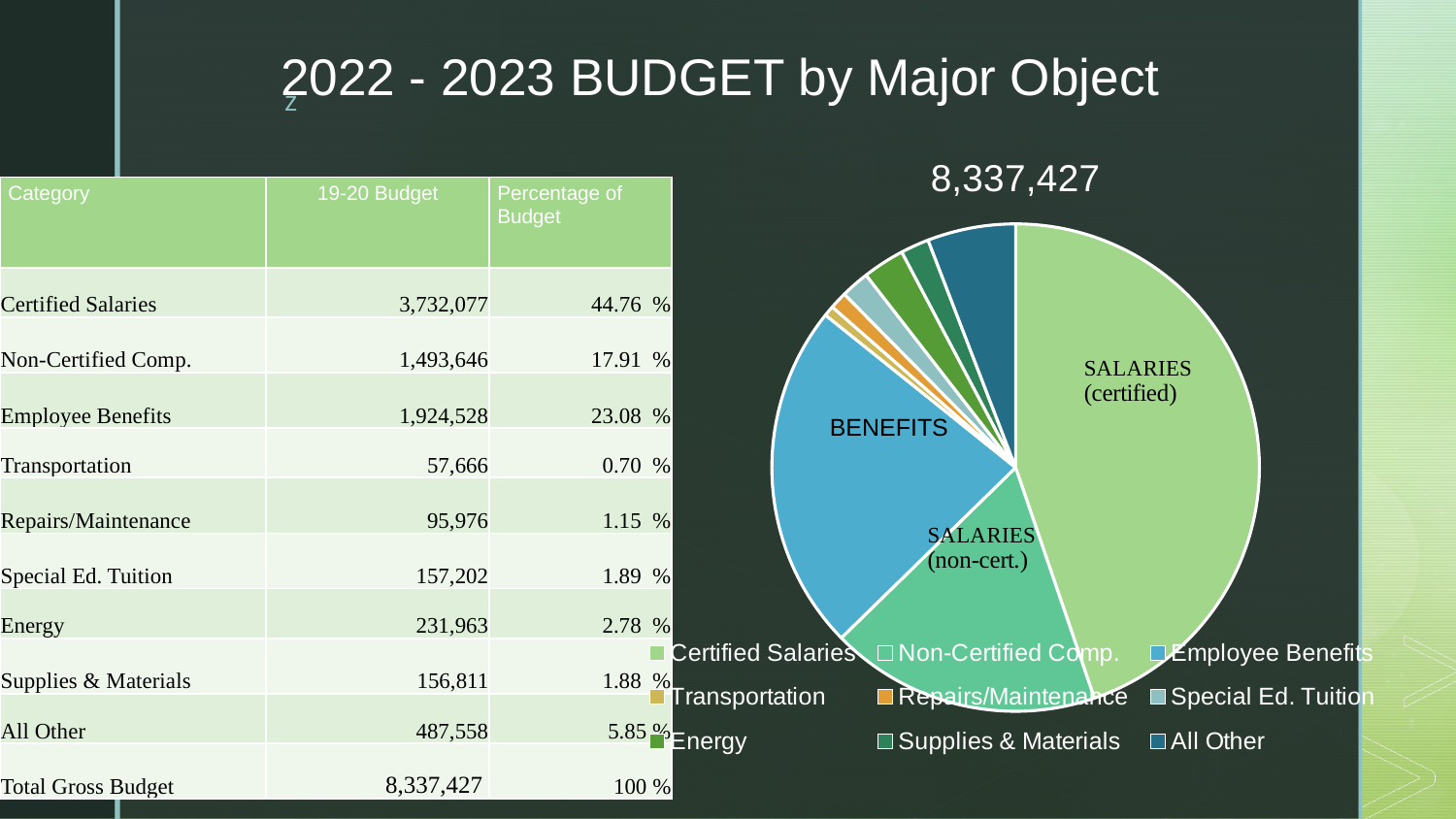
Which slice is larger in the pie chart, Employee Benefits or Non-Certified Comp.? Employee Benefits What share of the budget does the Non-Certified Comp. slice represent, according to the slide? 17.91 % What share of the budget does the Certified Salaries slice represent, according to the slide? 44.76 % Which category has the largest slice of the pie chart? Certified Salaries What kind of chart is shown on the slide? pie chart How many categories does the pie chart's legend list? 9 What is the title shown above the pie chart? 8,337,427 Which slice is larger in the pie chart, All Other or Transportation? All Other What is the total gross budget value shown for the pie chart? 8,337,427 What share of the budget does the Employee Benefits slice represent, according to the slide? 23.08 % What label is printed inside the largest slice of the pie chart? SALARIES (certified) Which slice is larger in the pie chart, Certified Salaries or Employee Benefits? Certified Salaries